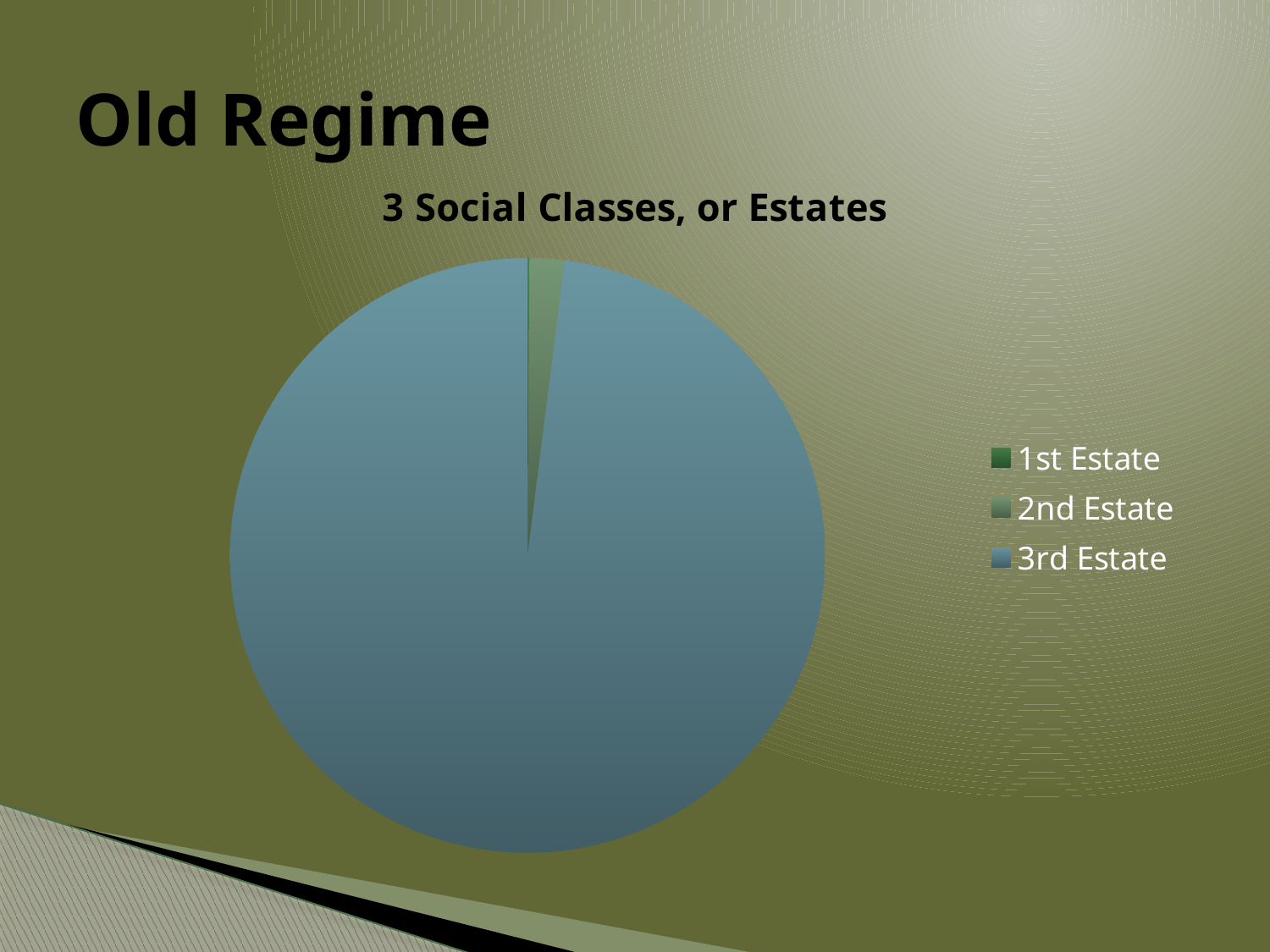
What is the title of the chart? 3 Social Classes, or Estates How many entries does the legend list? 3 Which slice is larger, the 3rd Estate or the 2nd Estate? 3rd Estate How many categories does the pie chart show? 3 Which estate has the largest slice of the pie? 3rd Estate What are the three categories listed in the legend? 1st Estate, 2nd Estate, 3rd Estate What kind of chart is shown on the slide? pie chart Which slice is larger, the 1st Estate or the 3rd Estate? 3rd Estate